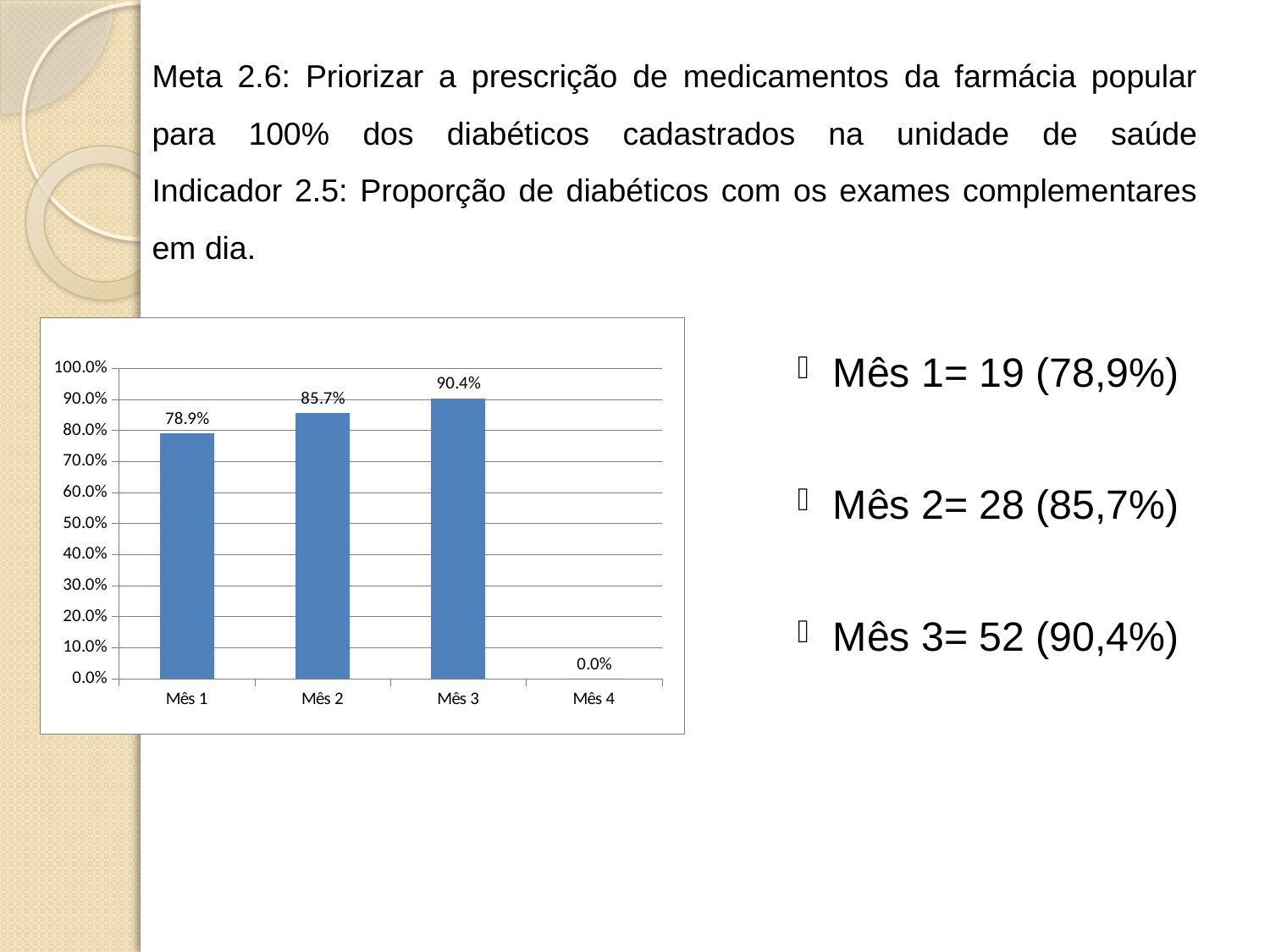
Which is larger, the value for Mês 2 or the value for Mês 1? Mês 2 What is the value for Mês 3? 90.4% Do the values rise or fall from Mês 1 to Mês 3? rise What is the value for Mês 4? 0.0% Which category has the highest value? Mês 3 Is the value for Mês 2 greater or less than 80.0%? greater What is the value for Mês 1? 78.9% What kind of chart is shown on the slide? bar chart What is the difference between the values for Mês 3 and Mês 1? 11.5% Which category has the lowest value? Mês 4 What is the value for Mês 2? 85.7% How many categories are shown on the x axis? 4